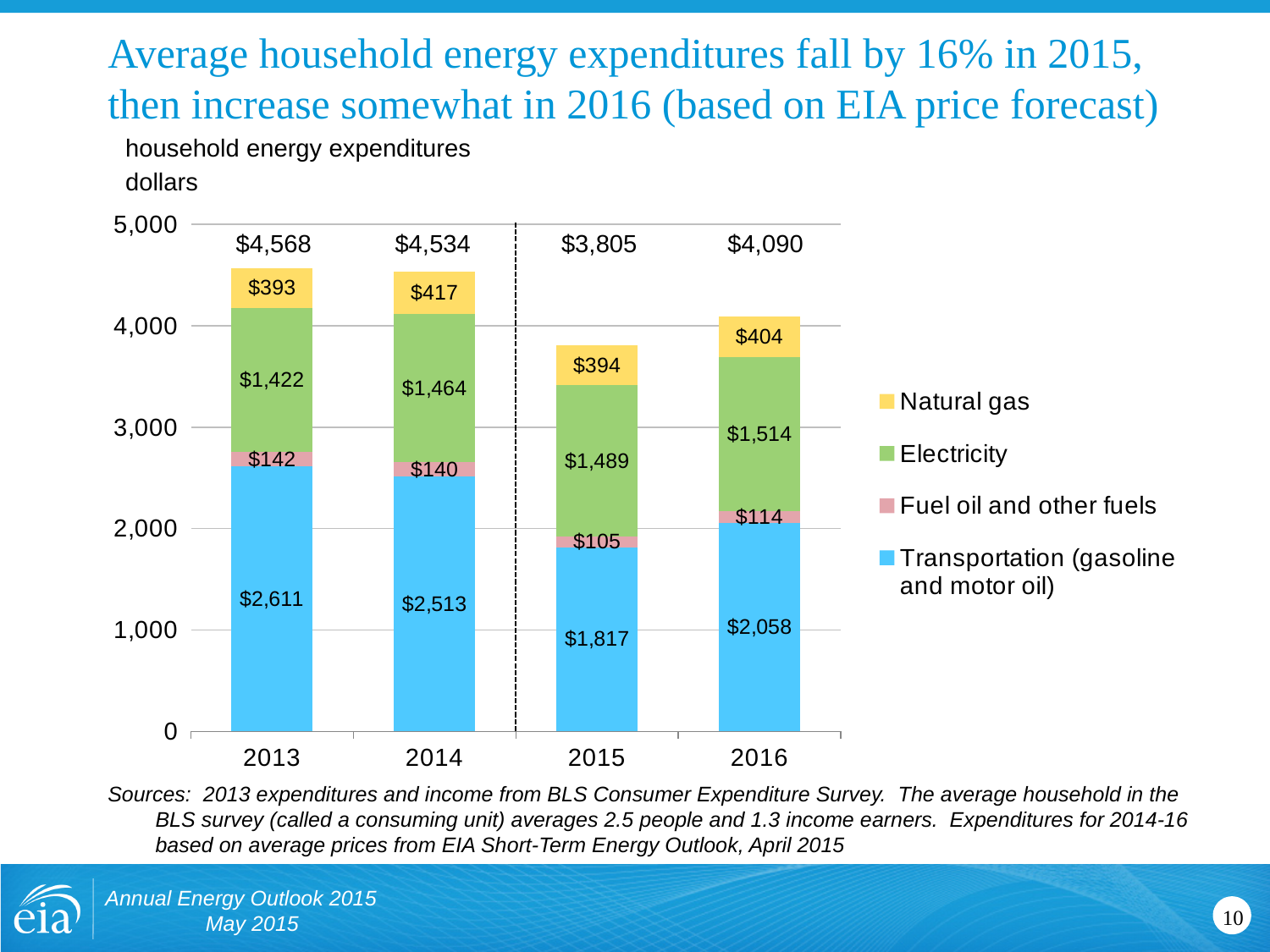
What is the difference between the Transportation expenditure in 2014 and in 2015? $696 What is the Natural gas expenditure in 2014? $417 How many years are shown on the x axis? 4 What is the total household energy expenditure in 2015? $3,805 What is the Fuel oil and other fuels expenditure in 2015? $105 Which year has the highest total household energy expenditure? 2013 What kind of chart is shown on the slide? Stacked bar chart Is the Electricity expenditure larger in 2015 or in 2016? 2016 How many series does the legend list? 4 What is the Transportation (gasoline and motor oil) expenditure in 2013? $2,611 Which year has the lowest total household energy expenditure? 2015 What is the Electricity expenditure in 2016? $1,514